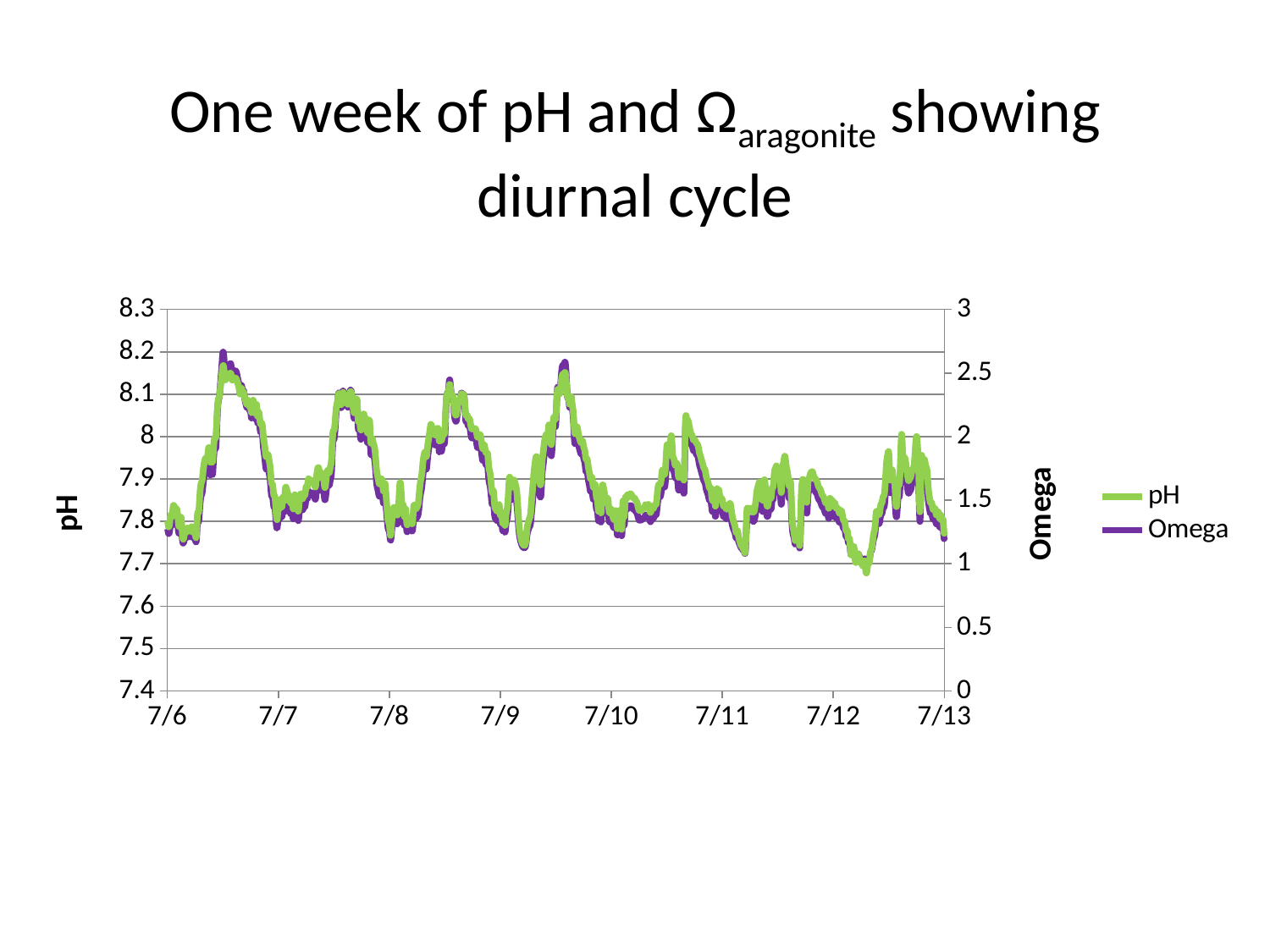
Is the highest Omega peak reached between 7/6 and 7/7 greater or less than 2? greater How many date labels are shown along the x axis? 8 What is the title of the right-hand vertical axis? Omega What kind of chart is shown on the slide? line chart Between which two x-axis dates does pH reach its lowest value of the week? 7/12 and 7/13 What are the two series named in the legend? pH and Omega Is the lowest pH value reached between 7/12 and 7/13 greater or less than 7.8? less Is the highest pH peak reached between 7/6 and 7/7 greater or less than 8.1? greater Do the daily peaks of pH generally rise or fall from 7/6 to 7/13? fall How many series does the legend list? 2